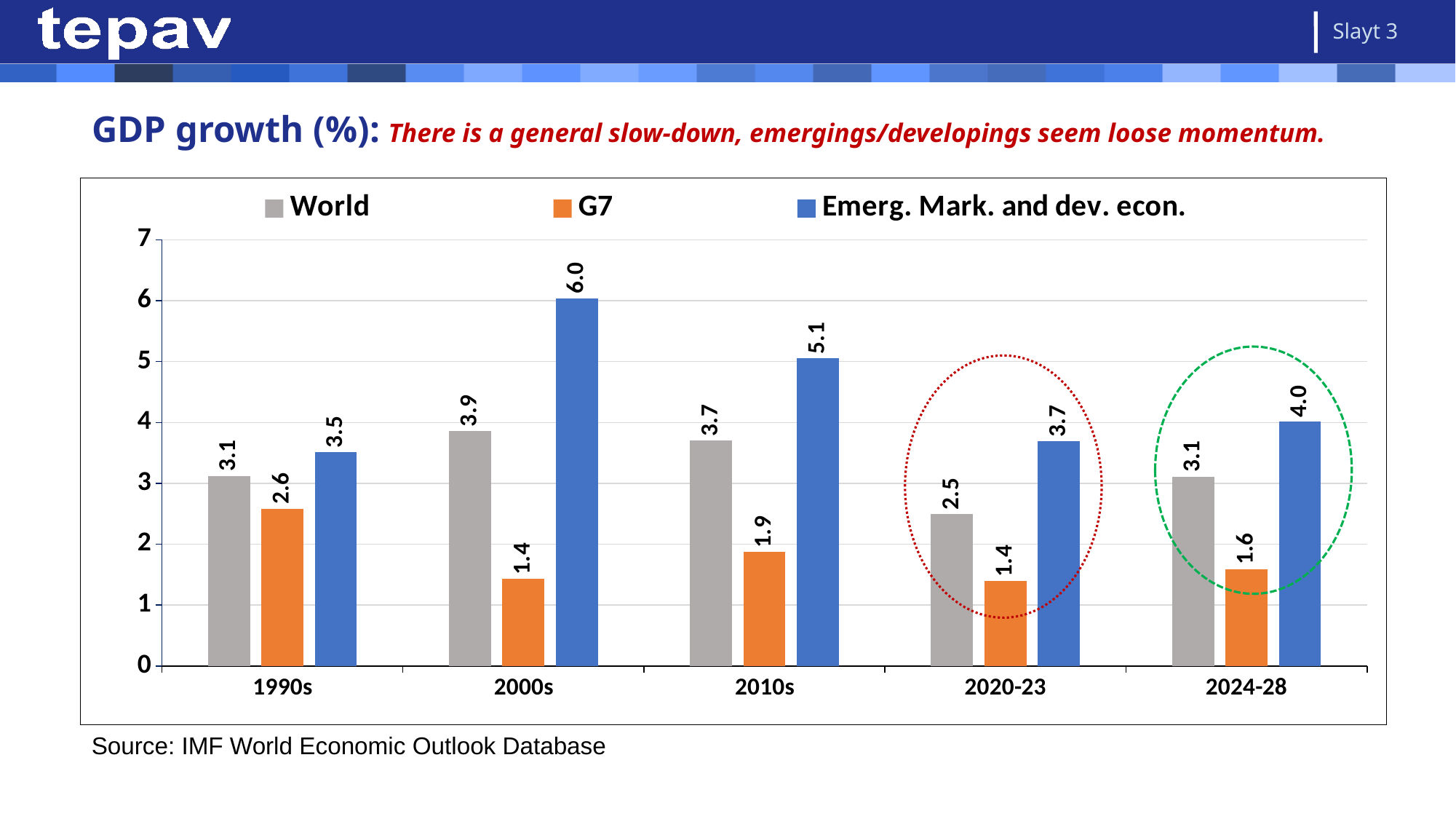
Which is larger in 2020-23: the World value or the Emerg. Mark. and dev. econ. value? Emerg. Mark. and dev. econ. Is the Emerg. Mark. and dev. econ. value for 2024-28 greater or less than 3? greater What is the GDP growth value for G7 in 2024-28? 1.6 In which period is the Emerg. Mark. and dev. econ. value highest? 2000s What is the difference between the Emerg. Mark. and dev. econ. value and the G7 value in the 2000s? 4.6 In which period is the World value lowest? 2020-23 Does the Emerg. Mark. and dev. econ. value rise or fall from the 2000s to 2020-23? fall What is the GDP growth value for the World in the 2000s? 3.9 How many series does the legend list? 3 What is the GDP growth value for Emerg. Mark. and dev. econ. in 2010s? 5.1 How many periods are shown on the x axis? 5 What kind of chart is shown on the slide? bar chart